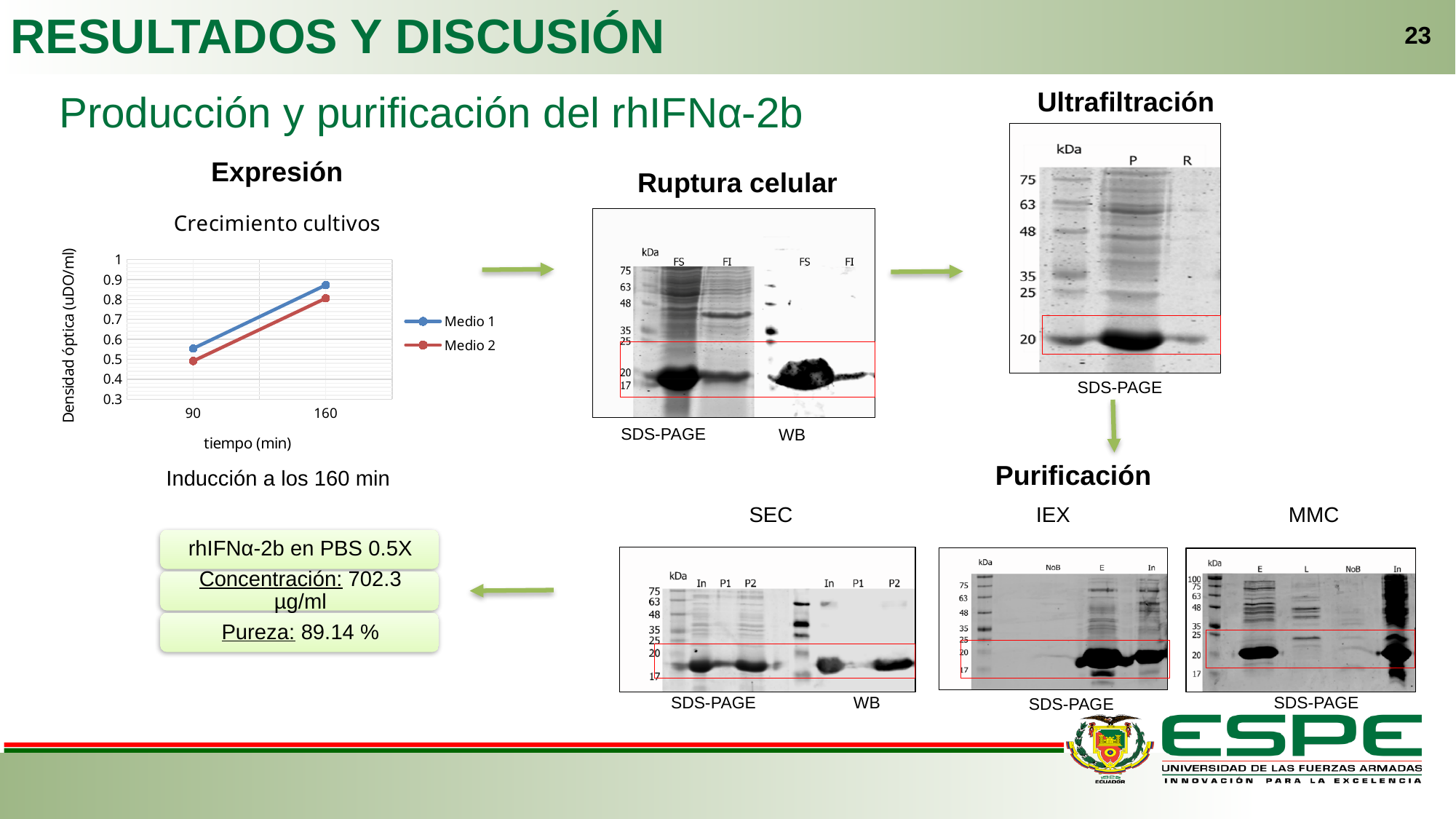
In the "Crecimiento cultivos" chart, is the value for Medio 1 at 90 min greater or less than 0.6? less In the "Crecimiento cultivos" chart, is the value for Medio 1 at 160 min greater or less than 0.8? greater In the "Crecimiento cultivos" chart, do the values for Medio 1 rise or fall from 90 to 160 min? rise How many time points are plotted on the x axis of the "Crecimiento cultivos" chart? 2 In the "Crecimiento cultivos" chart, which series has the higher value at 160 min, Medio 1 or Medio 2? Medio 1 In the "Crecimiento cultivos" chart, is the value for Medio 2 at 160 min greater or less than 0.7? greater In the "Crecimiento cultivos" chart, which series has the lower value at 90 min, Medio 1 or Medio 2? Medio 2 How many series does the legend of the "Crecimiento cultivos" chart list? 2 What is the label of the y axis of the "Crecimiento cultivos" chart? Densidad óptica (uDO/ml) What kind of chart is the "Crecimiento cultivos" chart? line chart What is the label of the x axis of the "Crecimiento cultivos" chart? tiempo (min)